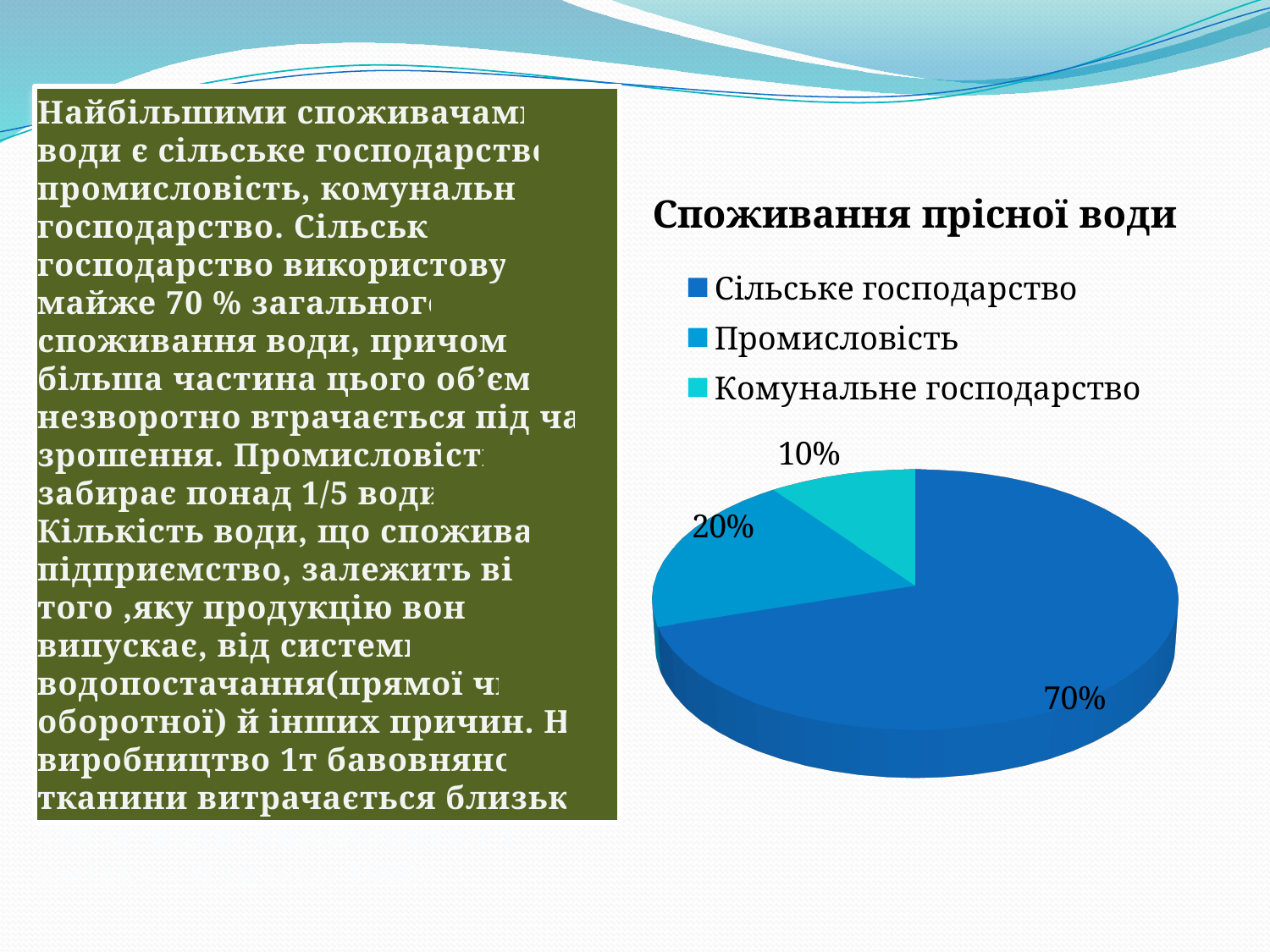
Which is larger, the share for Промисловість or the share for Комунальне господарство? Промисловість What type of chart is shown on the slide? pie chart How many entries does the legend list? 3 How many categories are shown in the pie chart? 3 Which category has the smallest slice of the pie? Комунальне господарство Which category has the largest slice of the pie? Сільське господарство What share of the pie does Промисловість take? 20% What share of the pie does Сільське господарство take? 70% What is the difference in percentage points between Сільське господарство and Промисловість? 50 What is the difference in percentage points between Промисловість and Комунальне господарство? 10 What is the title of the chart? Споживання прісної води What share of the pie does Комунальне господарство take? 10%